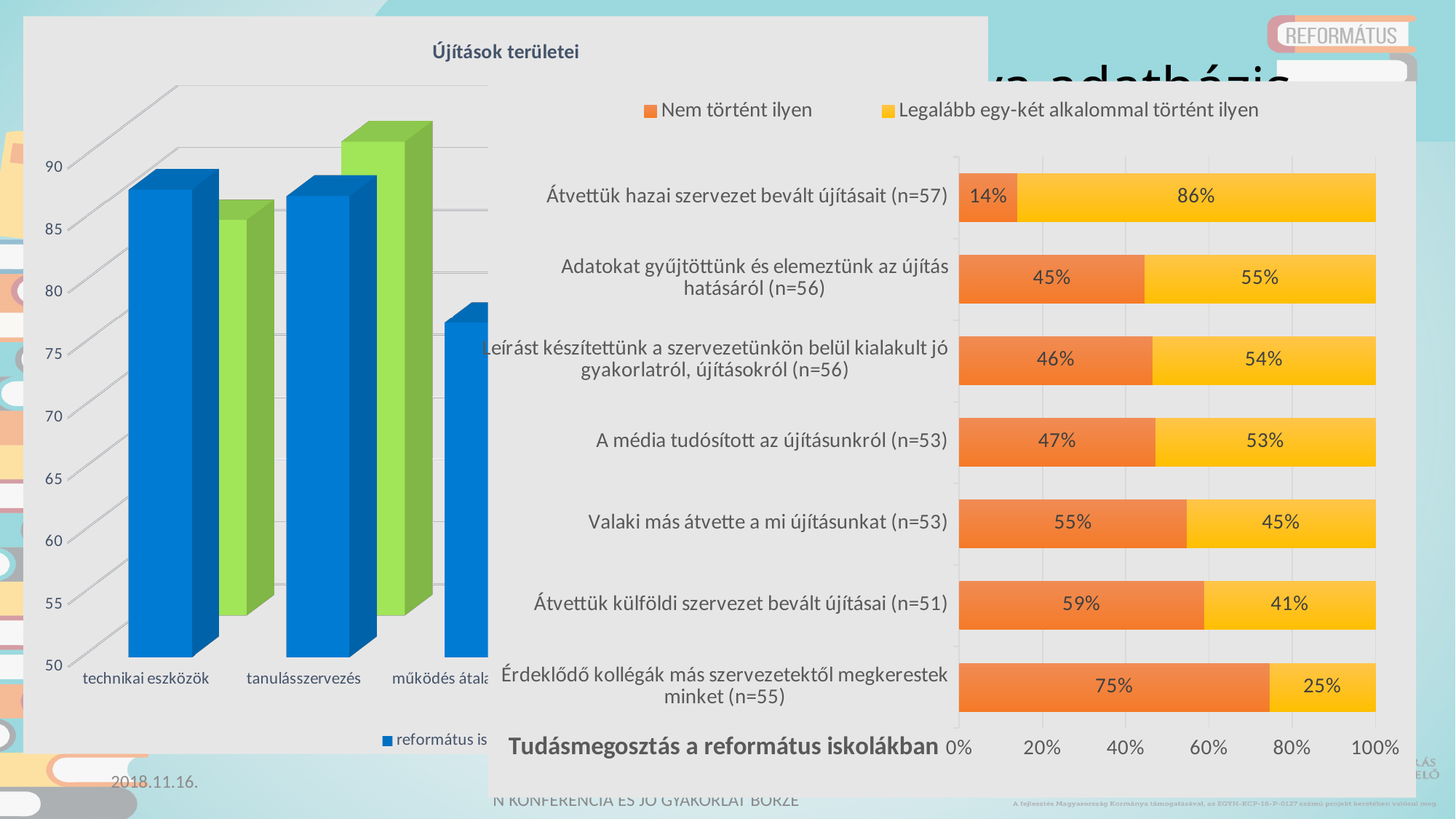
What kind of chart is 'Tudásmegosztás a református iskolákban'? Stacked bar chart In the chart titled 'Tudásmegosztás a református iskolákban', which category has the lowest 'Nem történt ilyen' share? Átvettük hazai szervezet bevált újításait (n=57) In the chart titled 'Tudásmegosztás a református iskolákban', what colour represents 'Nem történt ilyen'? Orange How many categories are shown in the chart titled 'Tudásmegosztás a református iskolákban'? 7 In the chart titled 'Tudásmegosztás a református iskolákban', which is larger for 'Valaki más átvette a mi újításunkat (n=53)': 'Nem történt ilyen' or 'Legalább egy-két alkalommal történt ilyen'? Nem történt ilyen In the chart titled 'Tudásmegosztás a református iskolákban', what percentage is shown for 'Legalább egy-két alkalommal történt ilyen' for 'A média tudósított az újításunkról (n=53)'? 53% In the chart titled 'Tudásmegosztás a református iskolákban', which category has the highest 'Legalább egy-két alkalommal történt ilyen' share? Átvettük hazai szervezet bevált újításait (n=57) What is the title of the chart on the left side of the slide? Újítások területei In the chart titled 'Tudásmegosztás a református iskolákban', what percentage is shown for 'Nem történt ilyen' for 'Átvettük hazai szervezet bevált újításait (n=57)'? 14% In the chart titled 'Tudásmegosztás a református iskolákban', what is the difference between the 'Nem történt ilyen' and 'Legalább egy-két alkalommal történt ilyen' values for 'Átvettük külföldi szervezet bevált újításai (n=51)'? 18% How many series does the legend of the chart titled 'Tudásmegosztás a református iskolákban' list? 2 In the chart titled 'Tudásmegosztás a református iskolákban', what is the 'Nem történt ilyen' value for 'Érdeklődő kollégák más szervezetektől megkerestek minket (n=55)'? 75%